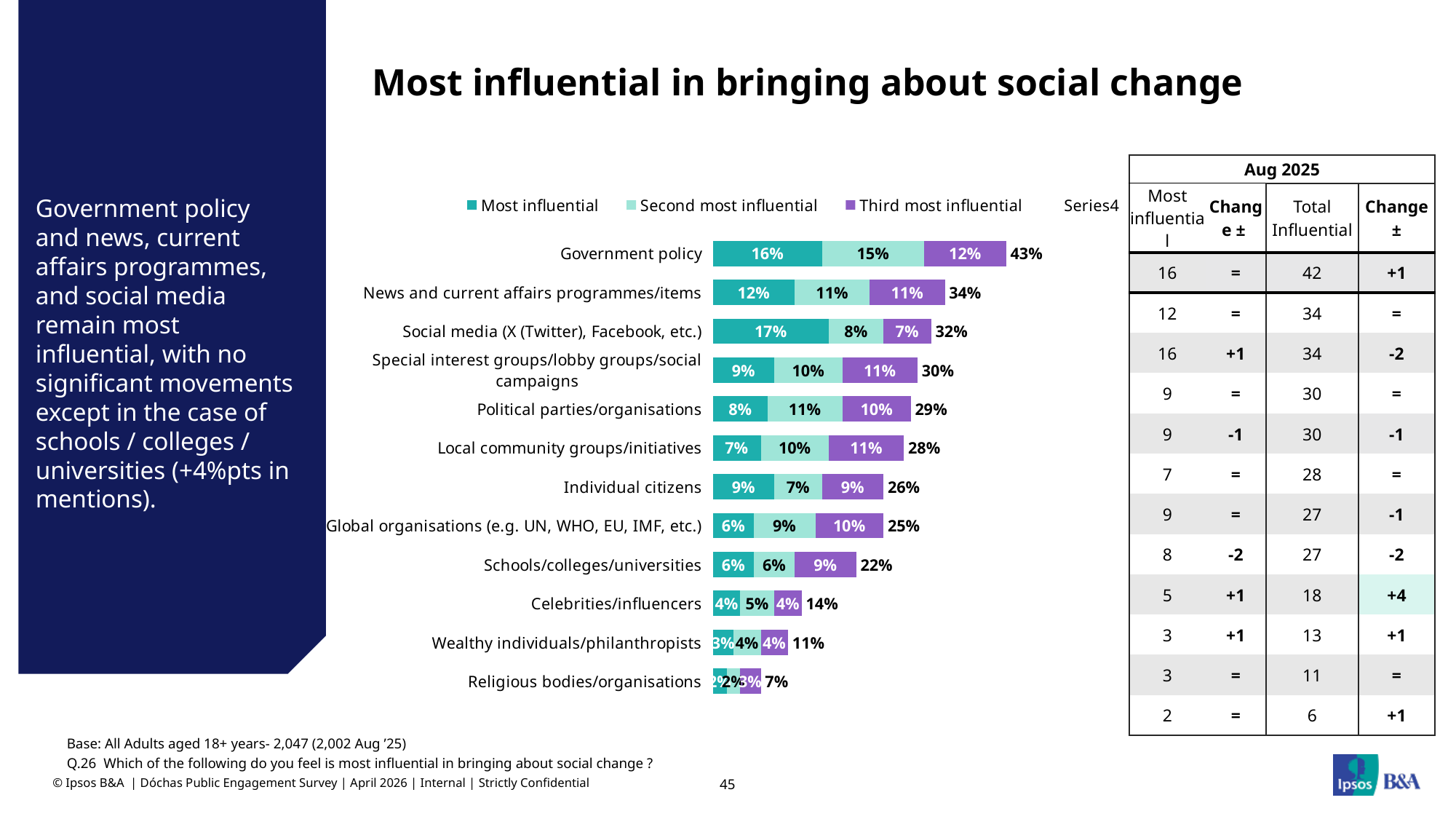
Which category has the lowest total across the three influence levels? Religious bodies/organisations What is the total of the stacked bar for Government policy? 43% What is the 'Most influential' value for Social media (X (Twitter), Facebook, etc.)? 17% What is the 'Second most influential' value for Government policy? 15% What is the difference between the total for Government policy and the total for News and current affairs programmes/items? 9 percentage points What type of chart is used on this slide? Stacked bar chart What is the 'Third most influential' value for Local community groups/initiatives? 11% How many categories are plotted in the bar chart? 12 What is the title of the chart? Most influential in bringing about social change Which has the larger 'Most influential' value: Social media (X (Twitter), Facebook, etc.) or Government policy? Social media (X (Twitter), Facebook, etc.) Which category has the highest total across the three influence levels? Government policy What is the total shown at the end of the Schools/colleges/universities bar? 22%